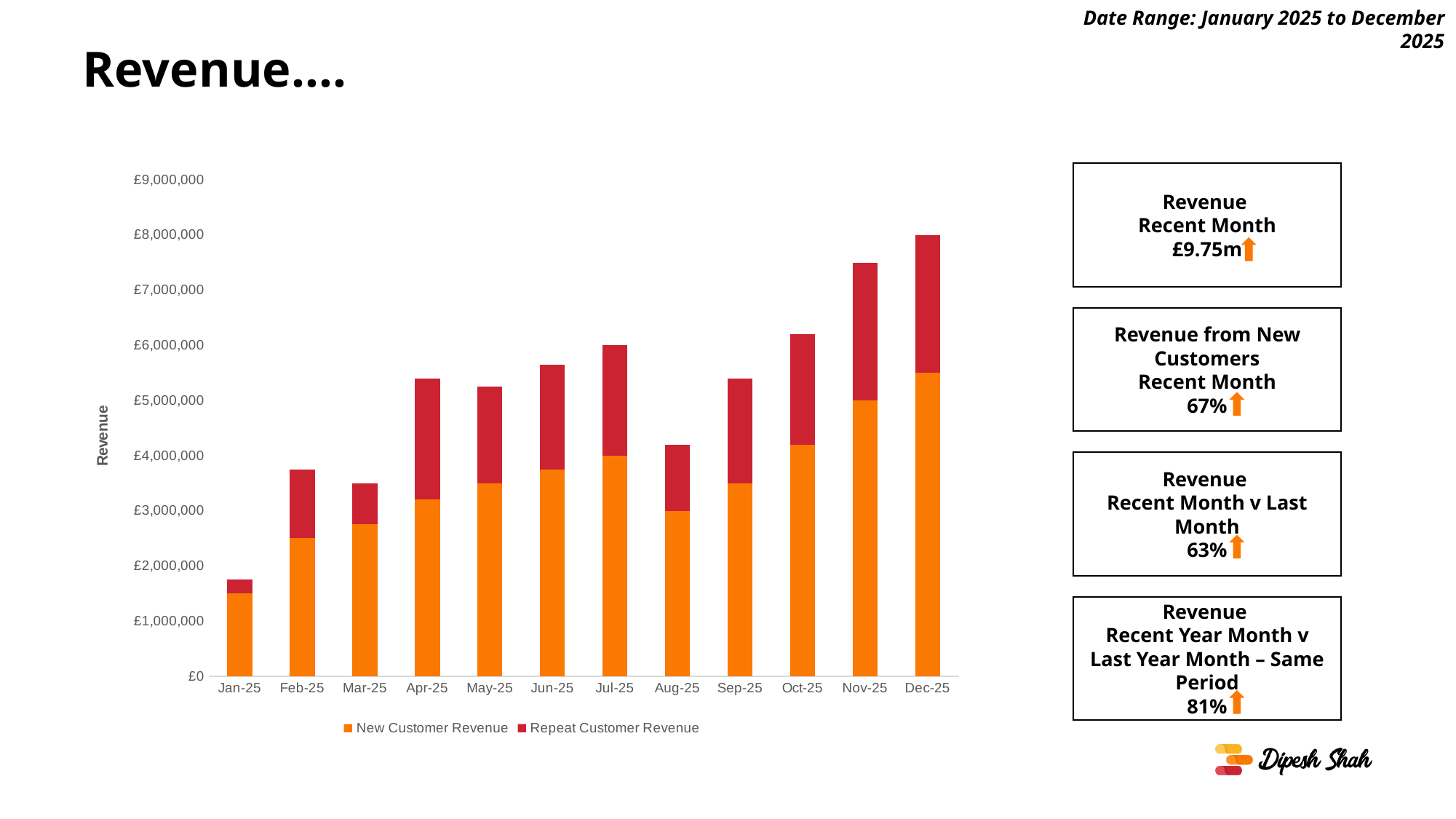
Which month has the lowest total revenue bar? Jan-25 What kind of chart is shown on the slide? Stacked bar chart Do the total revenue bars generally rise or fall from Jan-25 to Dec-25? Rise What are the two series named in the chart's legend? New Customer Revenue and Repeat Customer Revenue Is the New Customer Revenue for Dec-25 greater or less than £5,000,000? greater Which month has the larger total revenue bar, Oct-25 or Nov-25? Nov-25 Is the total revenue bar for Nov-25 greater or less than £7,000,000? greater How many months are plotted along the x axis of the chart? 12 Is the total revenue bar for Jan-25 greater or less than £2,000,000? less How many series does the chart's legend list? 2 Which month has the highest total revenue bar? Dec-25 Which month has the larger total revenue bar, Aug-25 or Sep-25? Sep-25